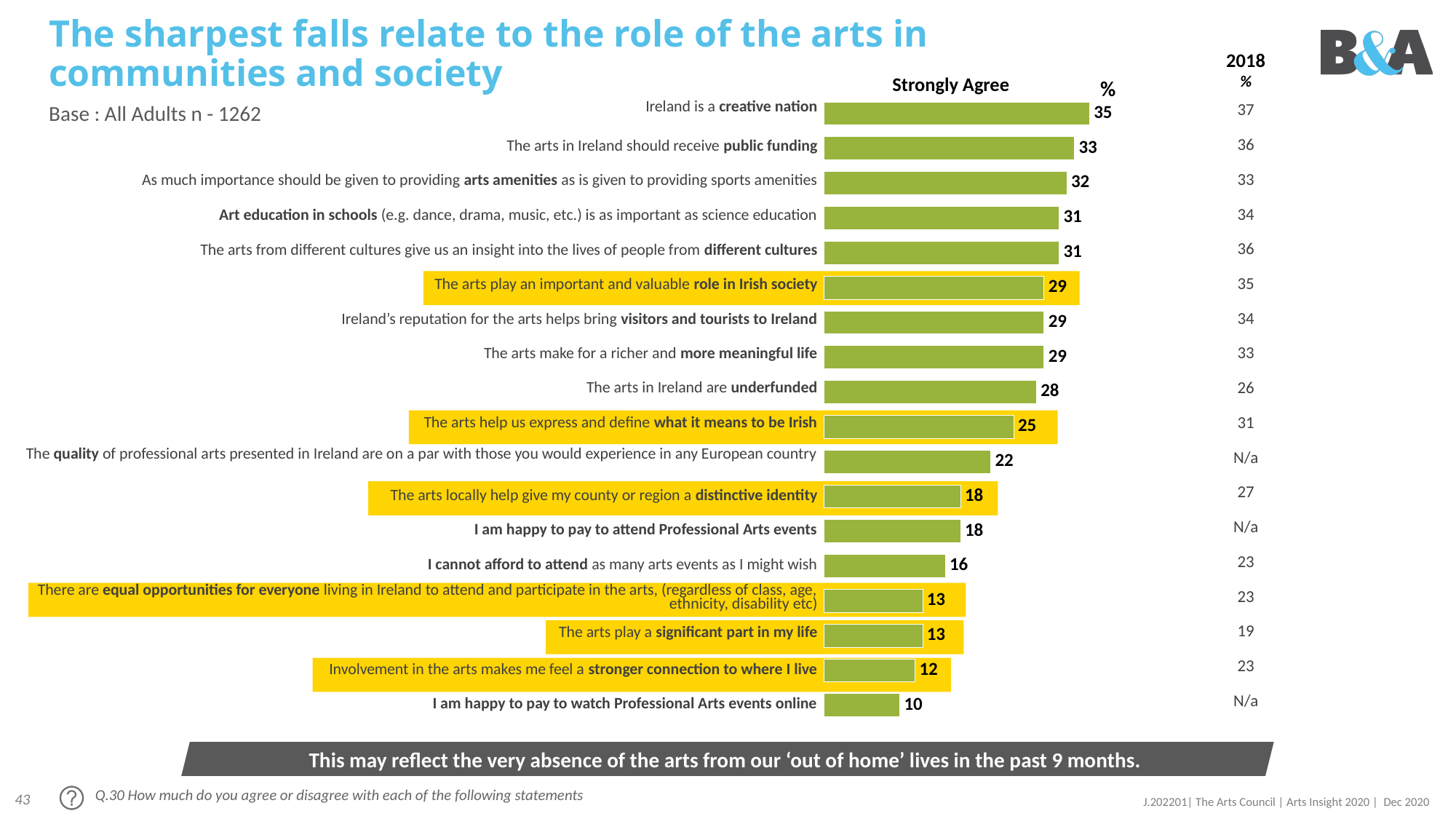
Which statement has the lowest Strongly Agree value? I am happy to pay to watch Professional Arts events online What is the Strongly Agree value for 'The arts in Ireland are underfunded'? 28 What kind of chart is shown on the slide? bar chart What is the Strongly Agree value for 'Ireland is a creative nation'? 35 What is the difference between the Strongly Agree values for 'Ireland is a creative nation' and 'I am happy to pay to watch Professional Arts events online'? 25 What is the Strongly Agree value for 'The arts locally help give my county or region a distinctive identity'? 18 Do the Strongly Agree values rise or fall going from the top bar to the bottom bar? fall How many statements are plotted in the bar chart? 18 Which statement has the highest Strongly Agree value? Ireland is a creative nation What is the 2018 % value shown for 'The arts play an important and valuable role in Irish society'? 35 What is the Strongly Agree value for 'Involvement in the arts makes me feel a stronger connection to where I live'? 12 Which has a higher Strongly Agree value: 'The arts in Ireland are underfunded' or 'The arts help us express and define what it means to be Irish'? The arts in Ireland are underfunded